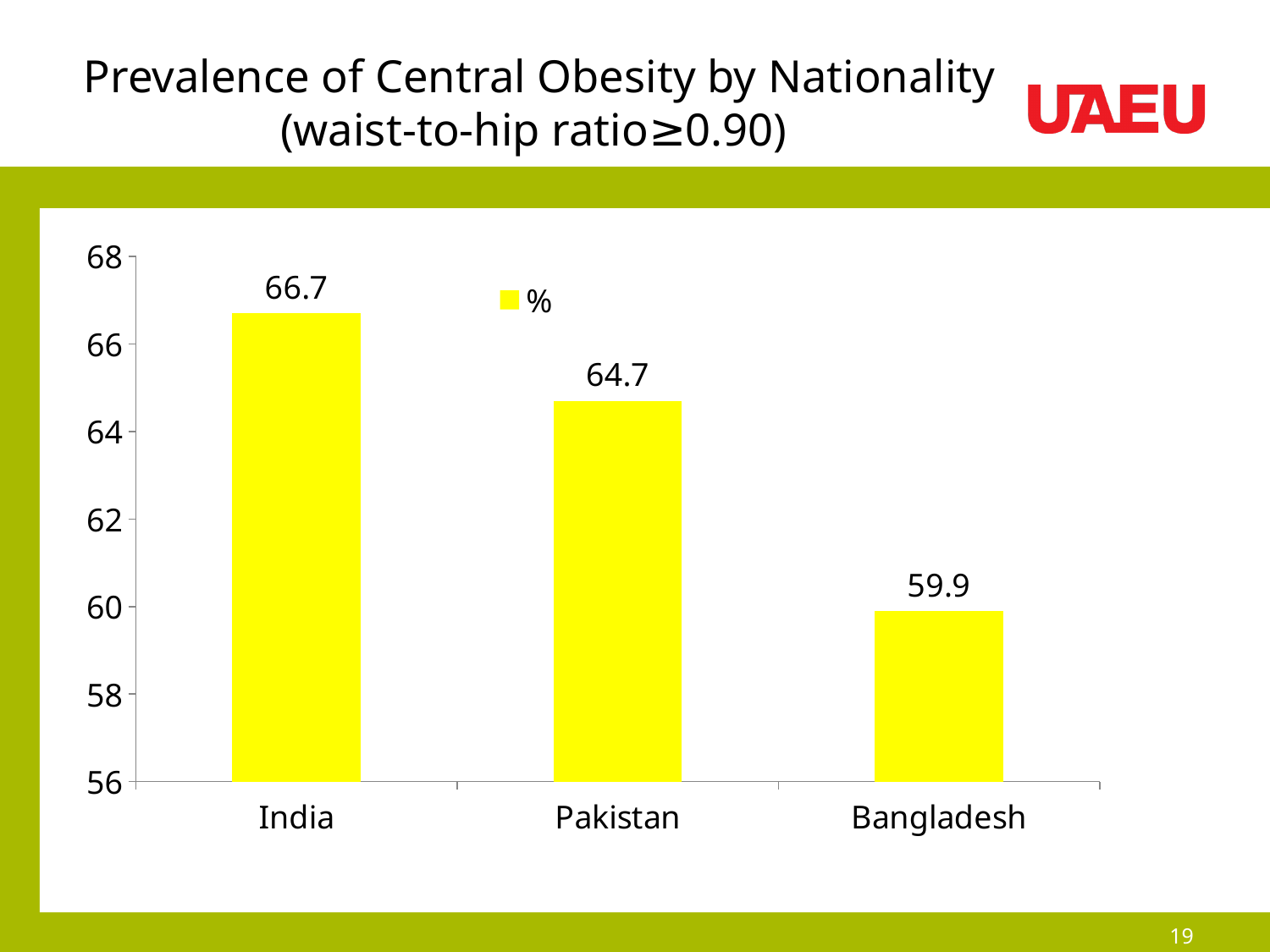
Which nationality has the highest value? India What is the value for Bangladesh? 59.9 What kind of chart is shown on the slide? bar chart What is the value for Pakistan? 64.7 Which nationality has the lowest value? Bangladesh What is the legend entry shown on the chart? % What is the value for India? 66.7 Is the value for Bangladesh greater or less than 60? less How many nationalities are shown on the chart? 3 What is the difference between the values for India and Bangladesh? 6.8 What is the difference between the values for India and Pakistan? 2.0 Which is larger, the value for Pakistan or the value for Bangladesh? Pakistan